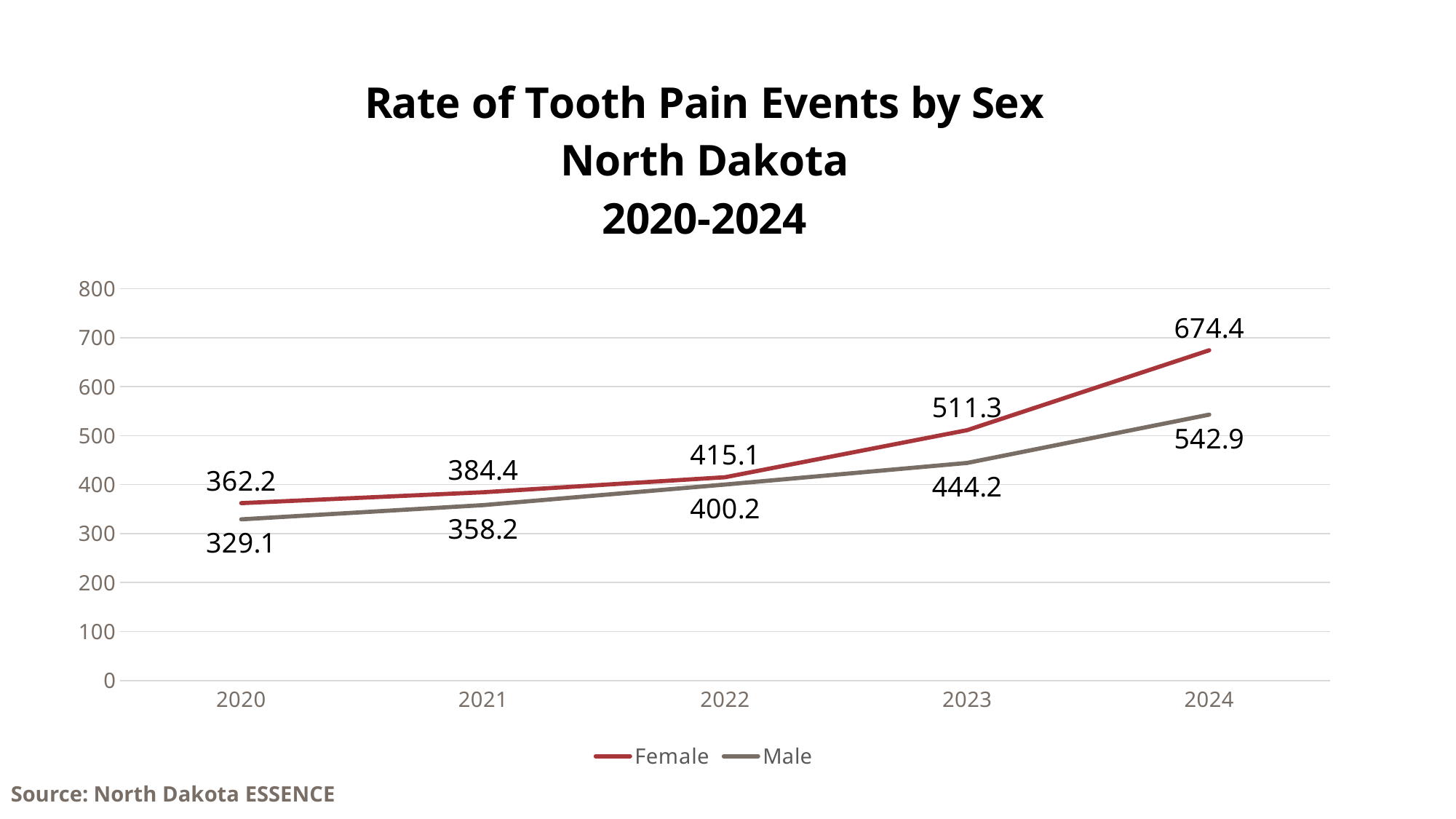
How many years are plotted on the x axis? 5 Which is larger in 2023, the Female rate or the Male rate? Female How many series does the legend list? 2 What is the Male rate of tooth pain events in 2022? 400.2 What is the difference between the Female and Male rates in 2024? 131.5 What is the difference between the Female rates in 2023 and 2022? 96.2 What is the Female rate of tooth pain events in 2024? 674.4 What is the Male rate of tooth pain events in 2020? 329.1 In which year is the Male rate lowest? 2020 What is the Female rate of tooth pain events in 2021? 384.4 What kind of chart is shown on the slide? Line chart In which year is the Female rate highest? 2024